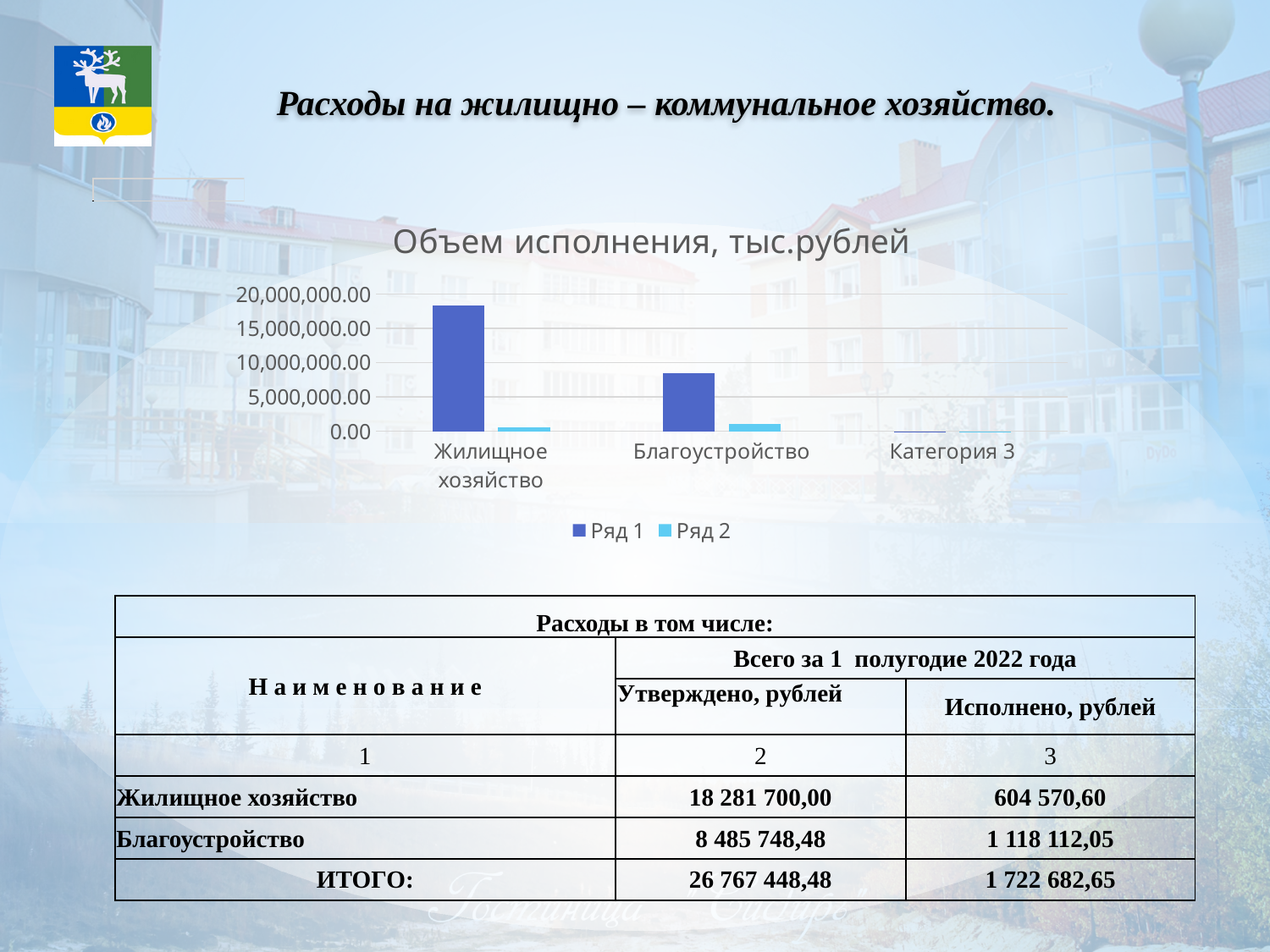
What are the names of the series in the chart legend? Ряд 1, Ряд 2 Is the Ряд 2 value for Благоустройство greater or less than 5,000,000.00? less How many categories are shown on the x axis of the chart? 3 For Ряд 1, which is larger: Жилищное хозяйство or Благоустройство? Жилищное хозяйство What is the title of the chart? Объем исполнения, тыс.рублей What kind of chart is shown on the slide? bar chart Is the Ряд 1 value for Жилищное хозяйство greater or less than 15,000,000.00? greater Is the Ряд 1 value for Благоустройство greater or less than 10,000,000.00? less How many series does the chart legend list? 2 Which category has the highest value for Ряд 1? Жилищное хозяйство For Благоустройство, which series has the larger value: Ряд 1 or Ряд 2? Ряд 1